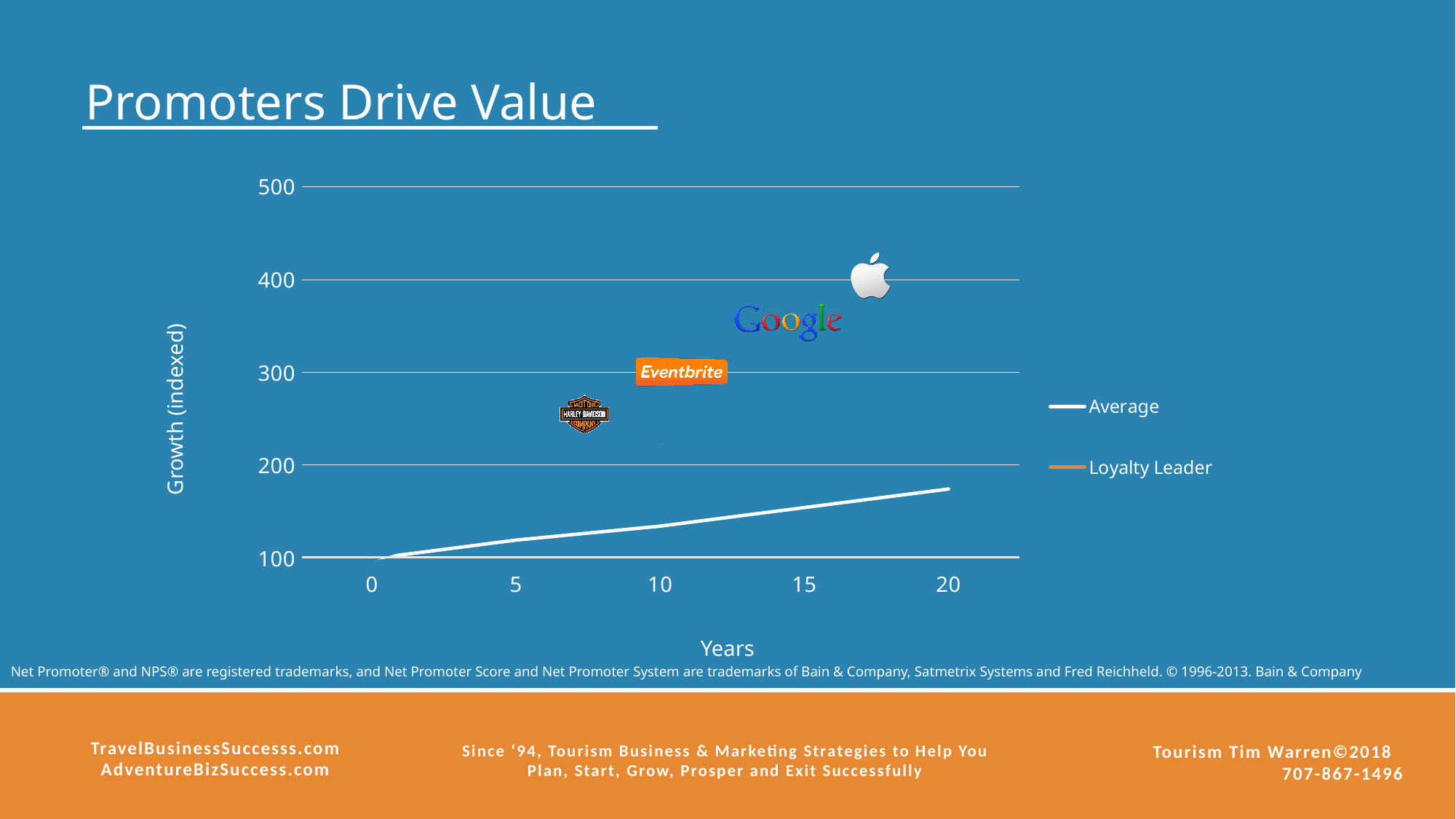
What kind of chart is shown on the slide? line chart What is the title of the chart on the slide? Promoters Drive Value What is the lowest value shown on the y axis? 100 How many series does the legend list? 2 What are the two series named in the legend? Average and Loyalty Leader Is the value of the Average line at year 10 greater or less than 200? less Is the value of the Average line at year 20 greater or less than 100? greater How many tick labels are shown on the x axis? 5 What is the largest value shown on the x axis? 20 What is the highest value shown on the y axis? 500 Is the value of the Average line at year 20 greater or less than 200? less Does the Average line rise or fall as the years increase? rise